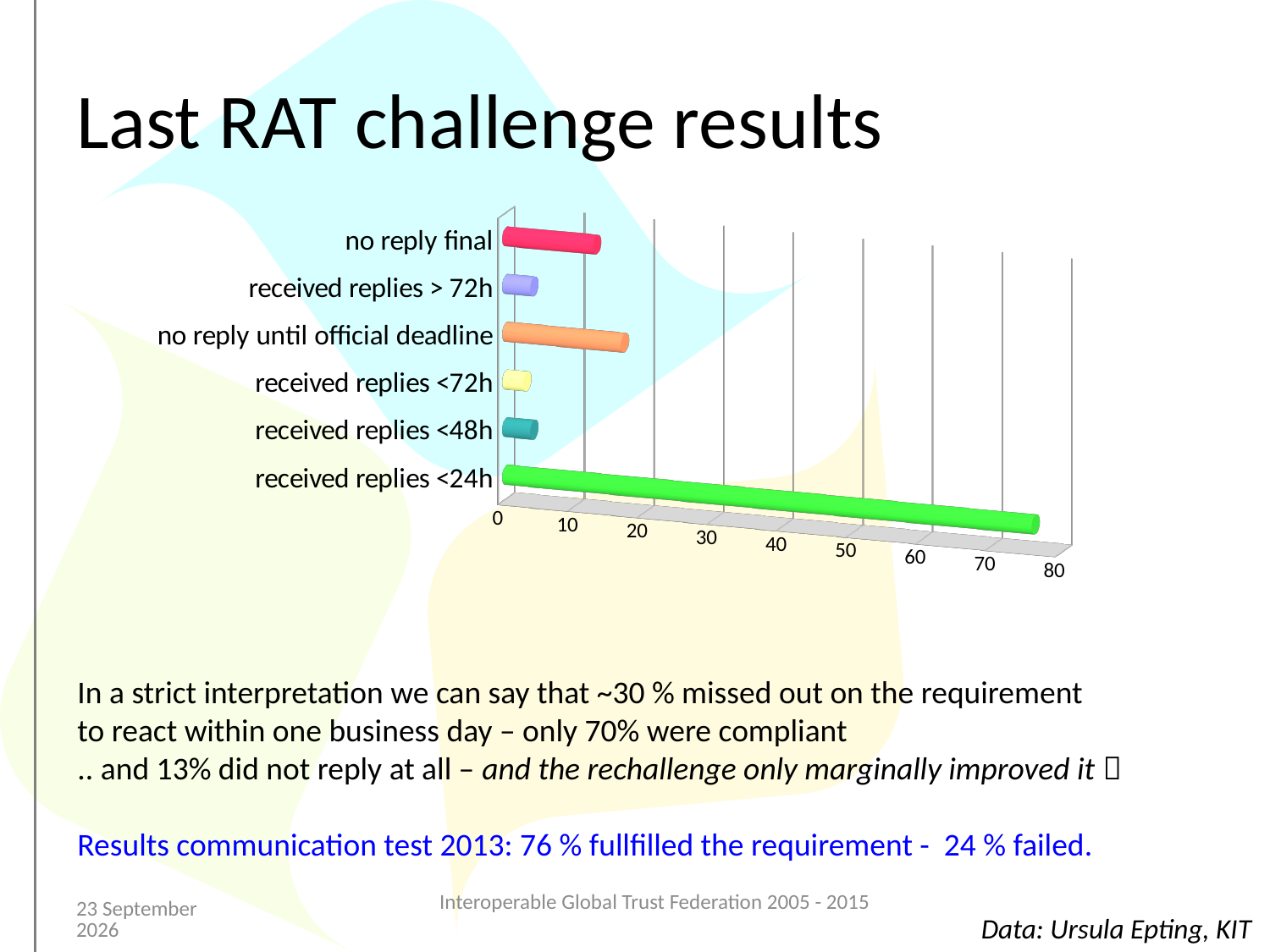
How many categories are plotted in the chart? 6 Is the value for no reply final greater or less than 20? less Which category has the highest value in the chart? received replies <24h What is the highest tick value shown on the value axis of the chart? 80 Which is larger, the value for received replies <24h or the value for no reply final? received replies <24h Is the value for received replies <72h greater or less than 10? less Is the value for no reply until official deadline greater or less than 10? greater Which is larger, the value for no reply until official deadline or the value for received replies > 72h? no reply until official deadline What colour is the bar for received replies <24h? green What kind of chart is shown on the slide? bar chart